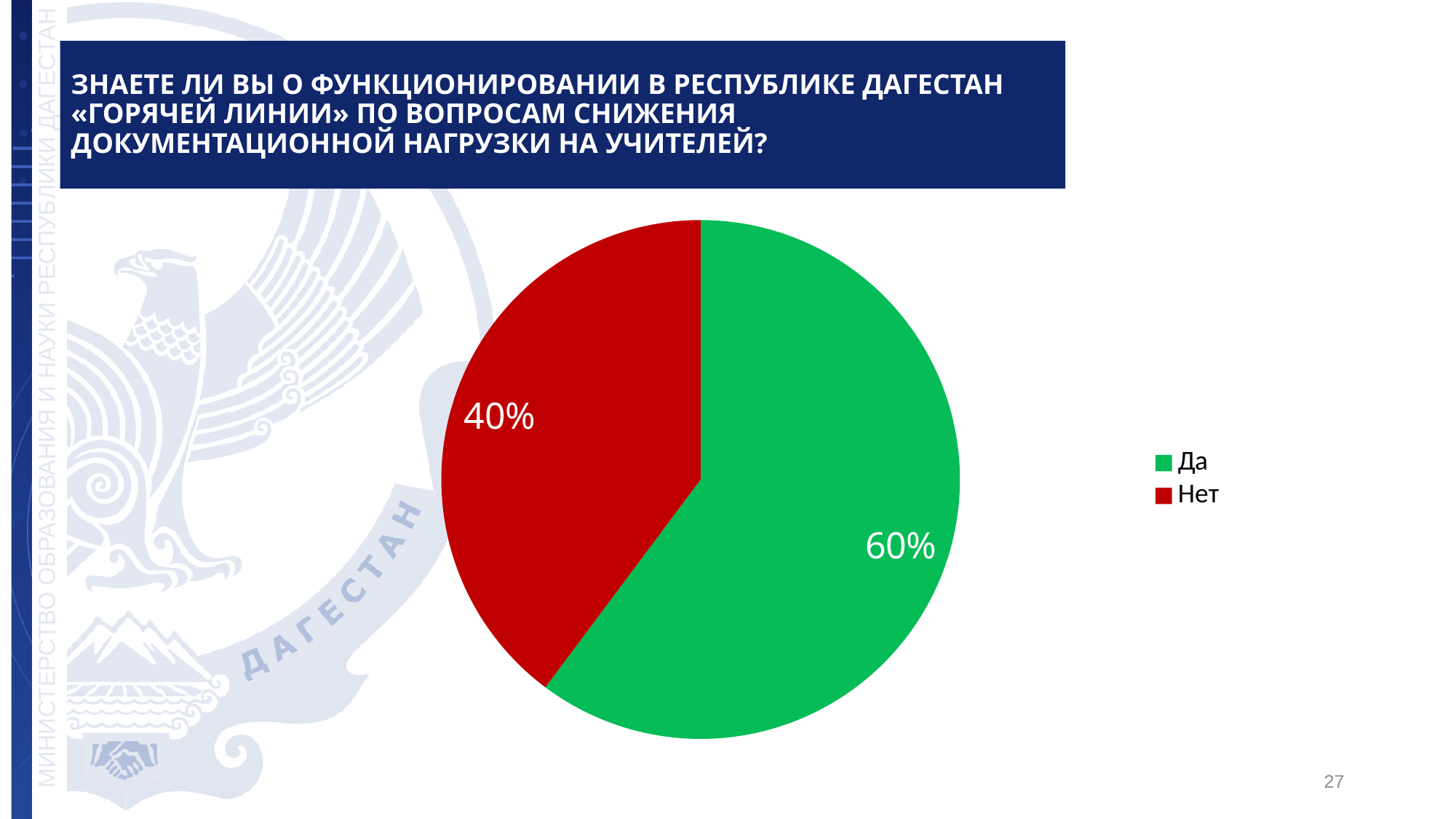
How many slices does the pie chart have? 2 What kind of chart is shown on the slide? pie chart What is the difference between the shares for "Да" and "Нет"? 20% What colour is the slice for "Нет"? red How many entries does the legend list? 2 Which category has the smallest slice of the pie? Нет What share of the pie does "Нет" have? 40% Which is larger, the share for "Да" or the share for "Нет"? Да What colour is the slice for "Да"? green Which category has the largest slice of the pie? Да What share of the pie does "Да" have? 60%